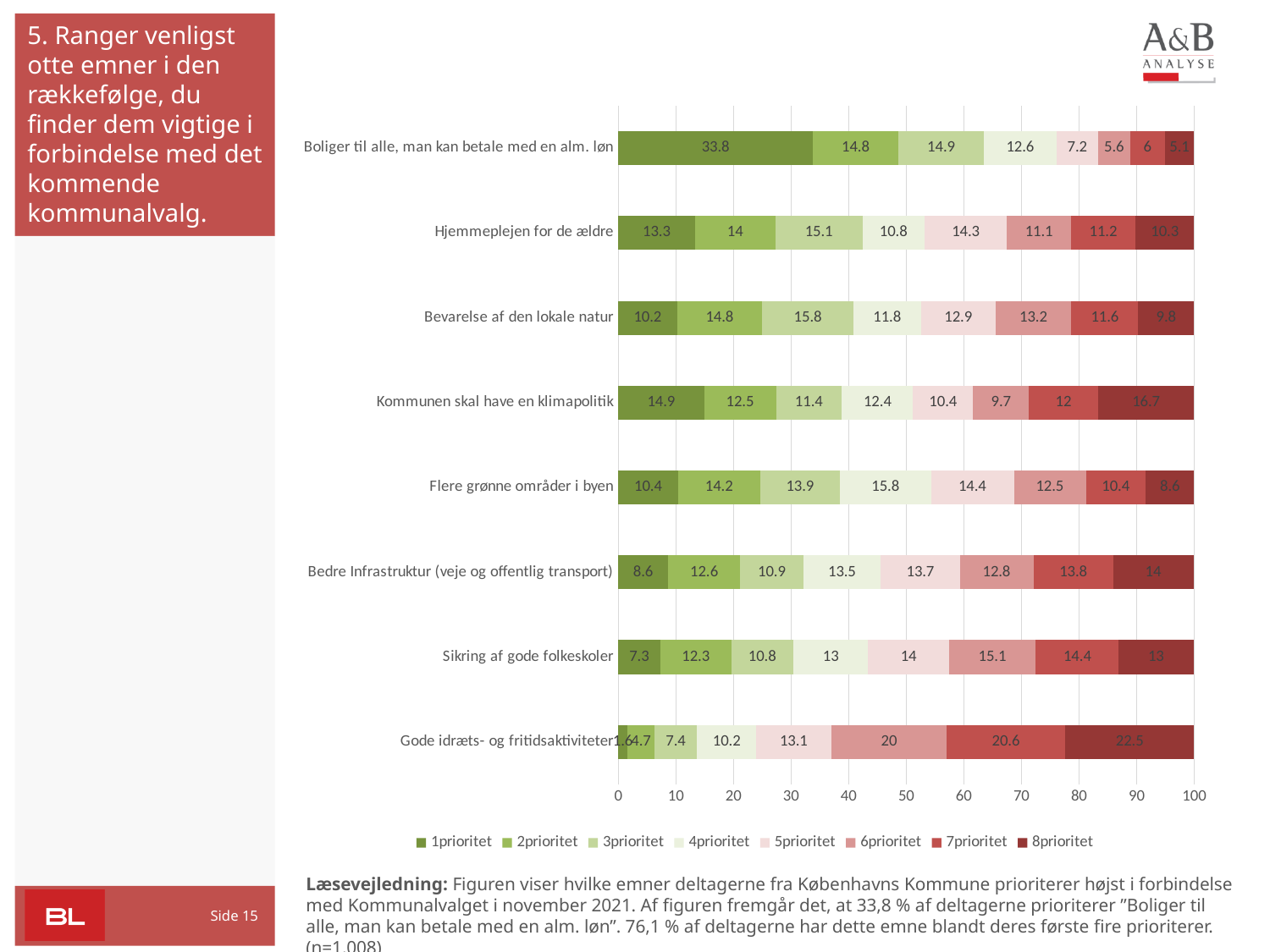
How many series does the legend list? 8 How many categories are shown on the chart? 8 What is the difference between the 1prioritet values for "Boliger til alle, man kan betale med en alm. løn" and "Hjemmeplejen for de ældre"? 20.5 Which has the larger 8prioritet value: "Gode idræts- og fritidsaktiviteter" or "Kommunen skal have en klimapolitik"? Gode idræts- og fritidsaktiviteter Which category has the highest 1prioritet value? Boliger til alle, man kan betale med en alm. løn What is the 1prioritet value for "Boliger til alle, man kan betale med en alm. løn"? 33.8 What kind of chart is shown on the slide? Stacked bar chart What is the 2prioritet value for "Bevarelse af den lokale natur"? 14.8 What is the 6prioritet value for "Sikring af gode folkeskoler"? 15.1 What is the total of the stacked bar for "Boliger til alle, man kan betale med en alm. løn"? 100 What is the 8prioritet value for "Kommunen skal have en klimapolitik"? 16.7 Which category has the lowest 1prioritet value? Gode idræts- og fritidsaktiviteter